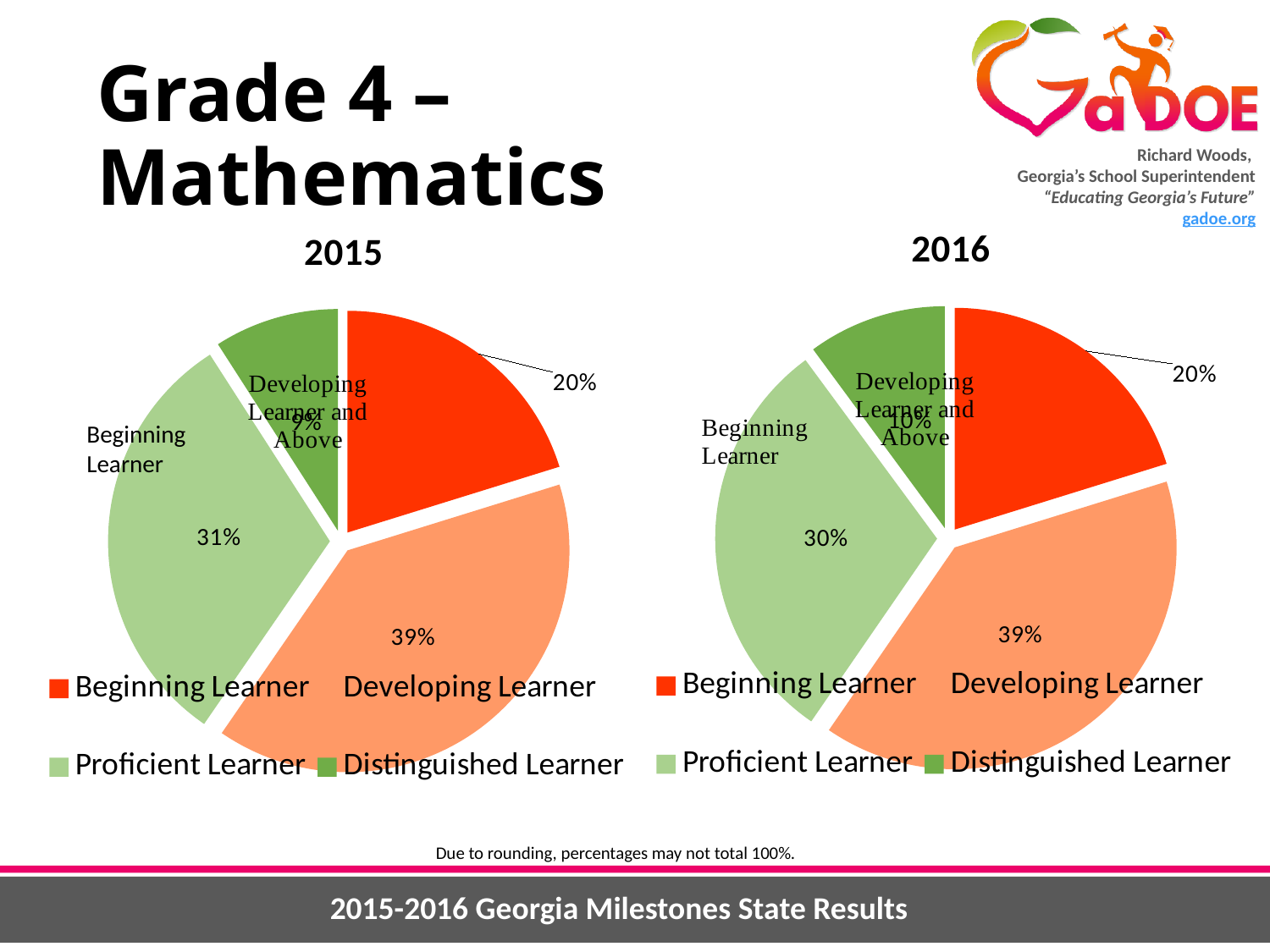
In the 2016 pie chart, which is larger, Proficient Learner or Beginning Learner? Proficient Learner In the 2015 pie chart, what percentage is shown for Developing Learner? 39% In the 2015 pie chart, which category has the largest share? Developing Learner In the 2016 pie chart, what percentage is shown for Developing Learner? 39% In the 2015 pie chart, what percentage is shown for Proficient Learner? 31% In the 2015 pie chart, what is the difference between the Developing Learner and Proficient Learner percentages? 8% What type of chart is used for the 2015 results? Pie chart In the 2016 pie chart, which category has the smallest share? Distinguished Learner In the 2016 pie chart, what percentage is shown for Beginning Learner? 20% In the 2016 pie chart, what percentage is shown for Proficient Learner? 30% In the 2015 pie chart, what percentage is shown for Beginning Learner? 20% How many categories does the legend of the 2016 chart list? 4